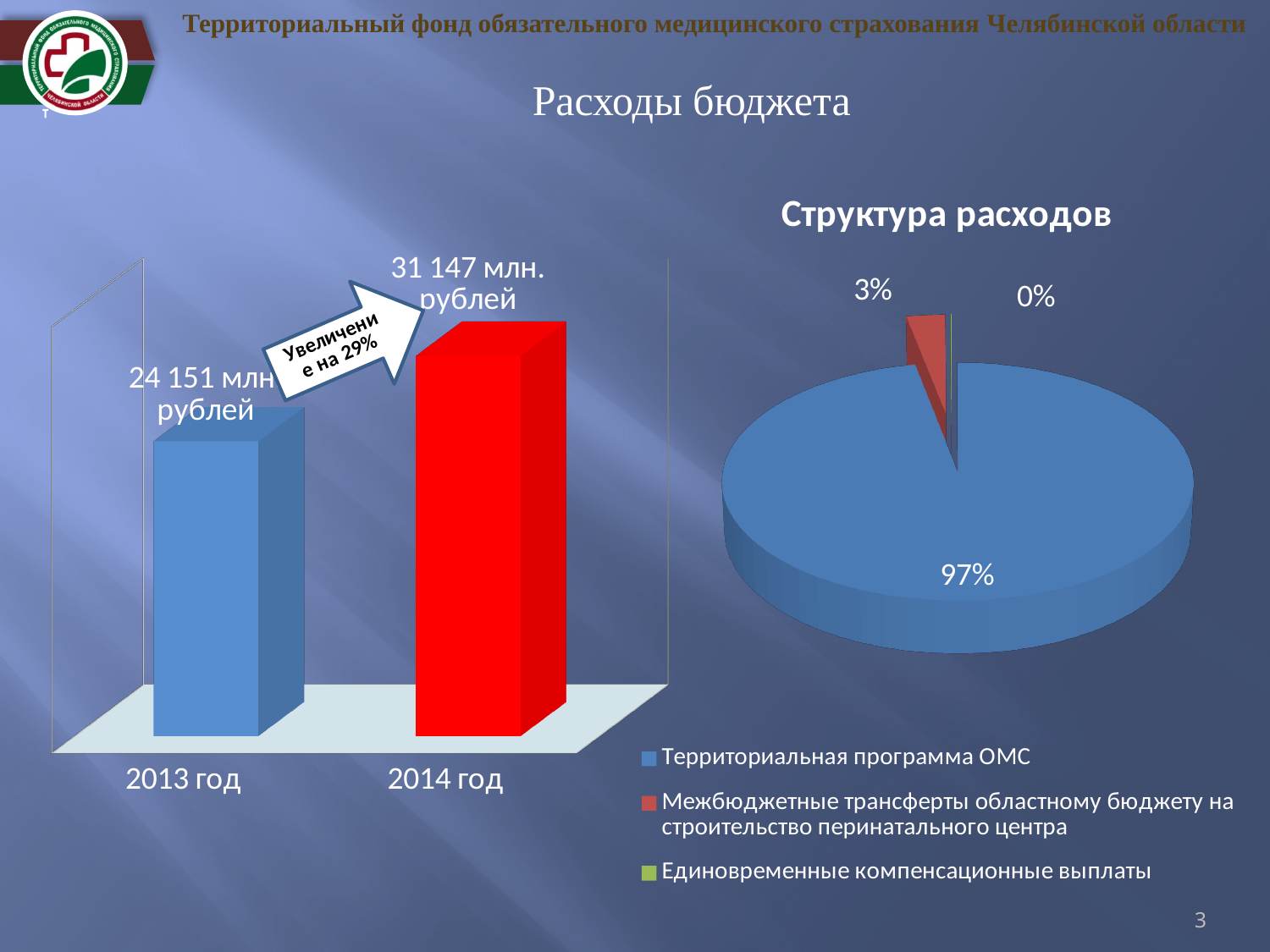
In the bar chart on the left, how many categories are shown? 2 In the bar chart on the left, what is the value for 2013 год? 24 151 млн. рублей What kind of chart is the chart on the left of the slide? bar chart In the bar chart on the left, which year has the higher value? 2014 год In the pie chart 'Структура расходов', what share do Межбюджетные трансферты областному бюджету на строительство перинатального центра have? 3% In the pie chart 'Структура расходов', how many entries does the legend list? 3 In the bar chart on the left, by how much does the 2014 год value exceed the 2013 год value? 6 996 млн. рублей In the bar chart on the left, what is the value for 2014 год? 31 147 млн. рублей In the pie chart 'Структура расходов', what share does Территориальная программа ОМС have? 97% In the bar chart on the left, which year has the lower value? 2013 год In the bar chart on the left, do the values rise or fall from 2013 год to 2014 год? rise In the bar chart on the left, what percentage increase does the arrow label state? Увеличение на 29%